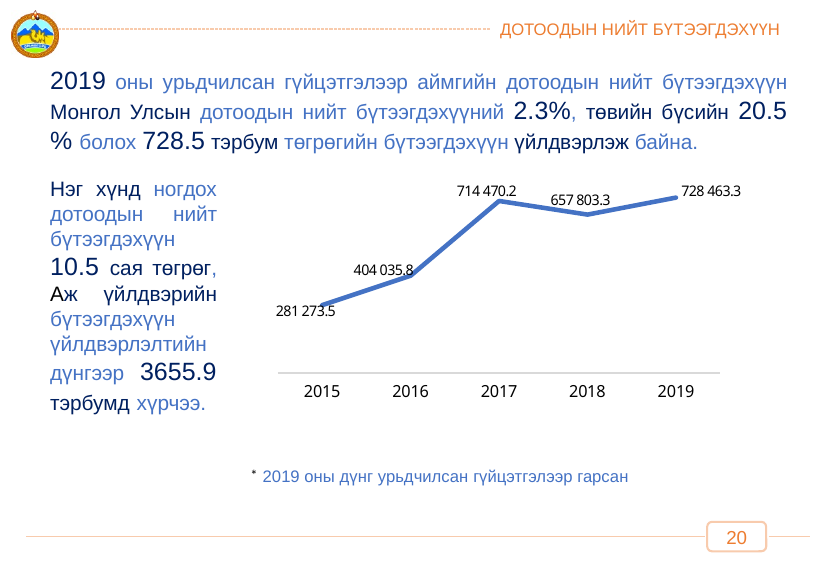
How many years are plotted on the chart? 5 What is the difference between the values for 2017 and 2018? 56 666.9 Which year has the lowest value? 2015 What type of chart is shown on the slide? Line chart Is the value for 2017 larger or smaller than the value for 2018? Larger Does the value rise or fall from 2015 to 2017? Rise What is the value for 2018? 657 803.3 What is the value for 2015? 281 273.5 What is the value for 2019? 728 463.3 What is the value for 2016? 404 035.8 Which year has the highest value? 2019 What is the value for 2017? 714 470.2